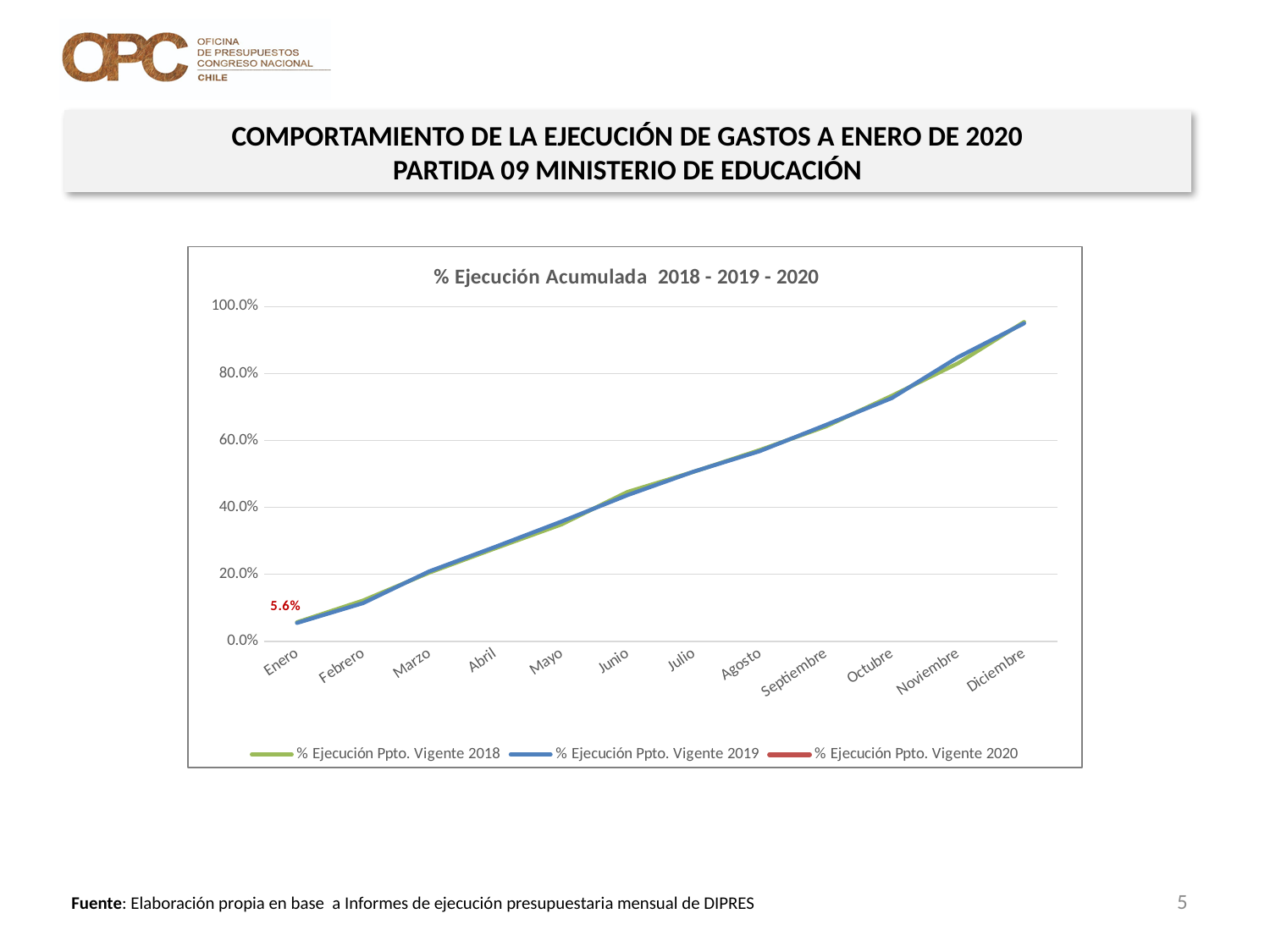
How many months are shown along the x axis of the chart? 12 Which month has the lowest value for % Ejecución Ppto. Vigente 2018? Enero Is the value for % Ejecución Ppto. Vigente 2018 in Octubre greater or less than 60.0%? greater Is the value for % Ejecución Ppto. Vigente 2019 in Febrero greater or less than 20.0%? less What is the title of the chart? % Ejecución Acumulada 2018 - 2019 - 2020 Which month has the highest value for % Ejecución Ppto. Vigente 2019? Diciembre What kind of chart is shown on the slide? line chart How many series does the chart legend list? 3 Do the values for % Ejecución Ppto. Vigente 2019 rise or fall from Enero to Diciembre? rise What value is labelled on the chart for Enero for % Ejecución Ppto. Vigente 2020? 5.6% Which series is listed last in the chart legend? % Ejecución Ppto. Vigente 2020 Is the value for % Ejecución Ppto. Vigente 2019 in Diciembre greater or less than 80.0%? greater